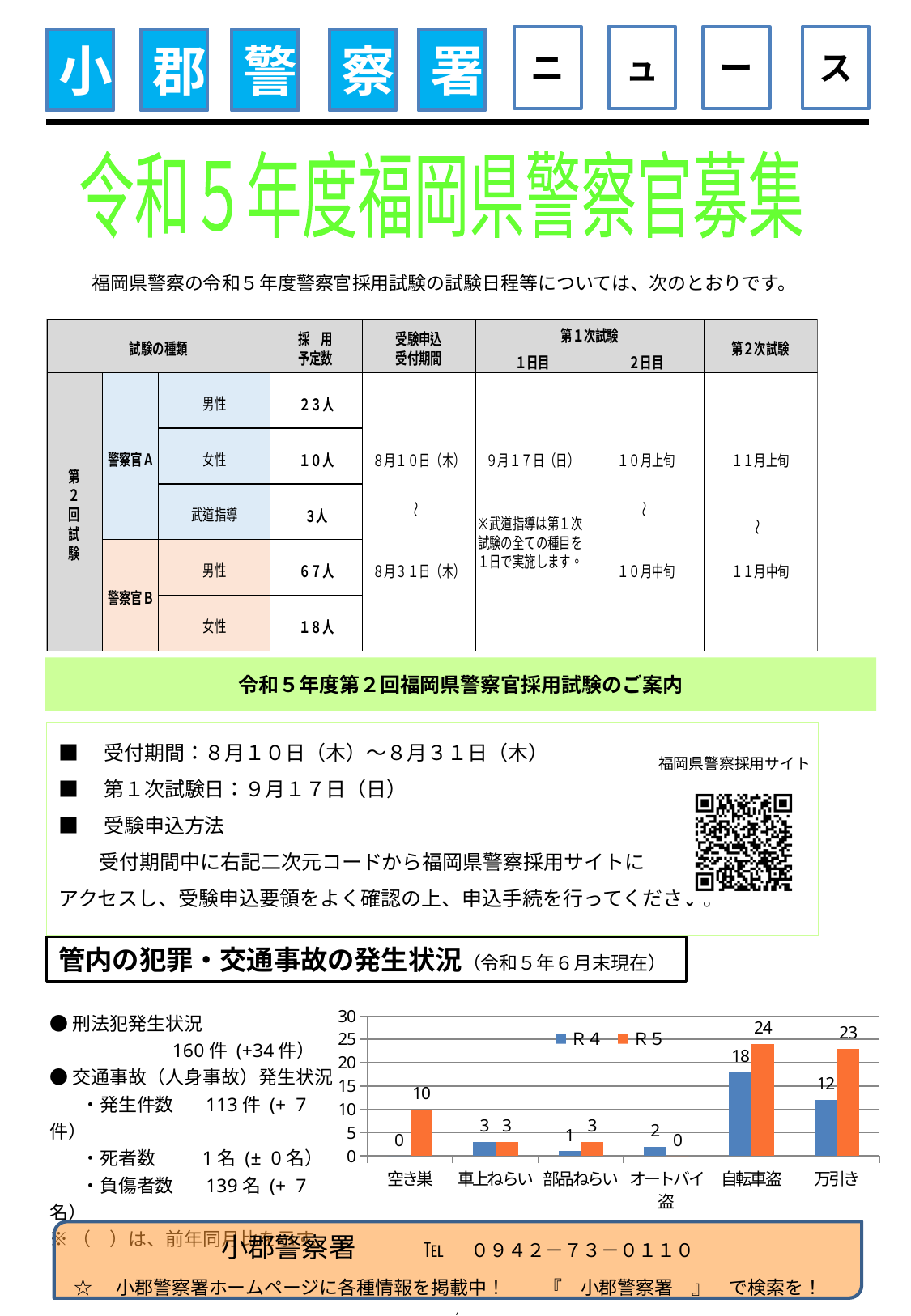
What is the R4 value for オートバイ盗 in the bar chart? 2 Which is larger for 部品ねらい, the R4 value or the R5 value? R5 Which category has the highest R5 value in the bar chart? 自転車盗 What is the R5 value for 自転車盗 in the bar chart? 24 What is the difference between the R5 and R4 values for 万引き? 11 How many categories are shown on the x axis of the bar chart? 6 Which series is shown in orange in the bar chart? R5 What kind of chart is shown on the slide? bar chart How many series does the legend of the bar chart list? 2 What is the R4 value for 万引き in the bar chart? 12 Which category has the lowest R4 value in the bar chart? 空き巣 What is the R5 value for 空き巣 in the bar chart? 10